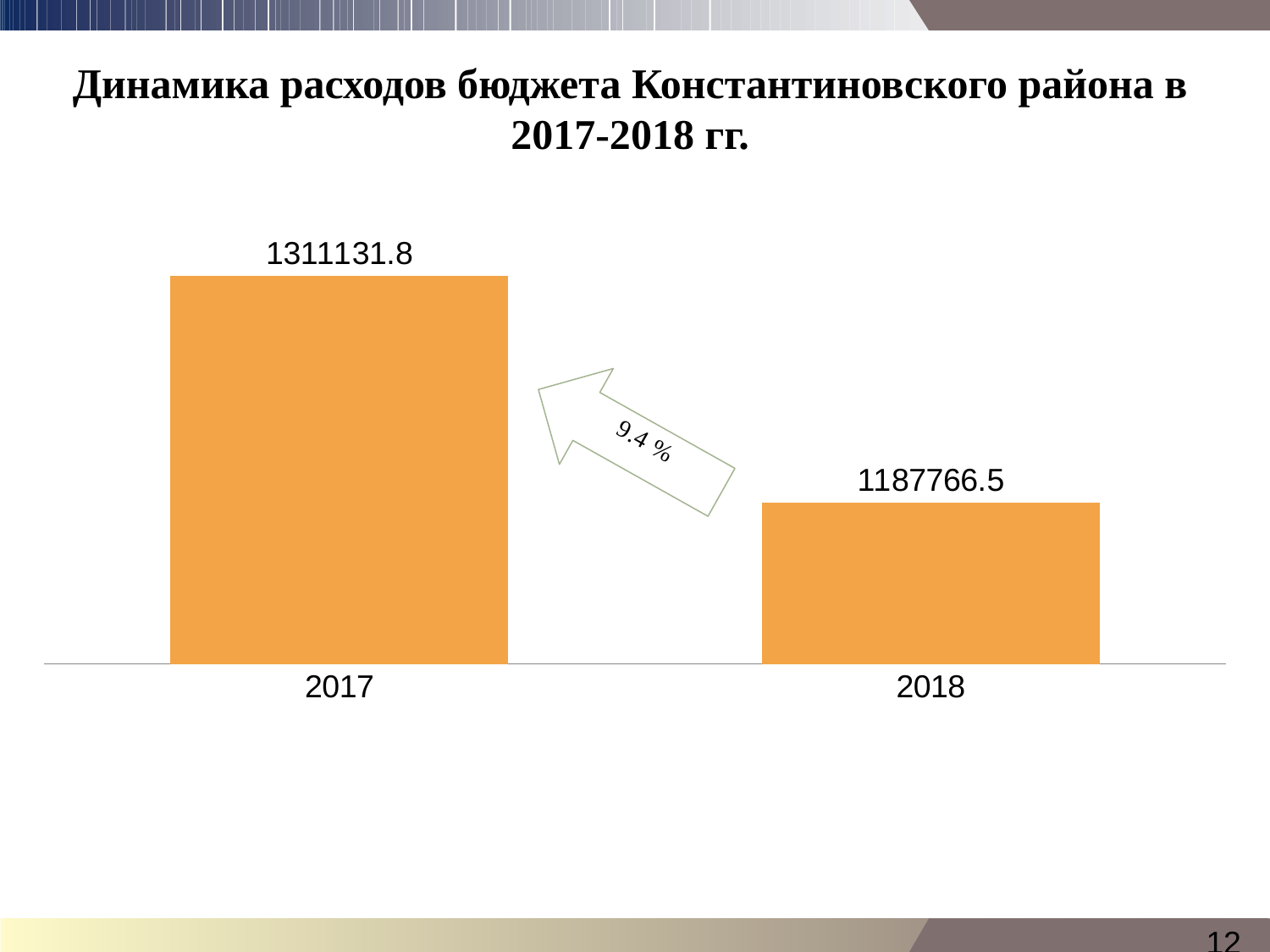
What is the value shown for 2018? 1187766.5 What colour are the bars in the chart? orange How many bars are plotted in the chart? 2 Is the value for 2018 larger or smaller than the value for 2017? smaller What kind of chart is shown on the slide? bar chart Do the values rise or fall from 2017 to 2018? fall Which year has the higher value? 2017 What percentage is written on the arrow between the two bars? 9.4 % Which year has the lower value? 2018 What is the difference between the 2017 and 2018 values? 123365.3 What is the value shown for 2017? 1311131.8